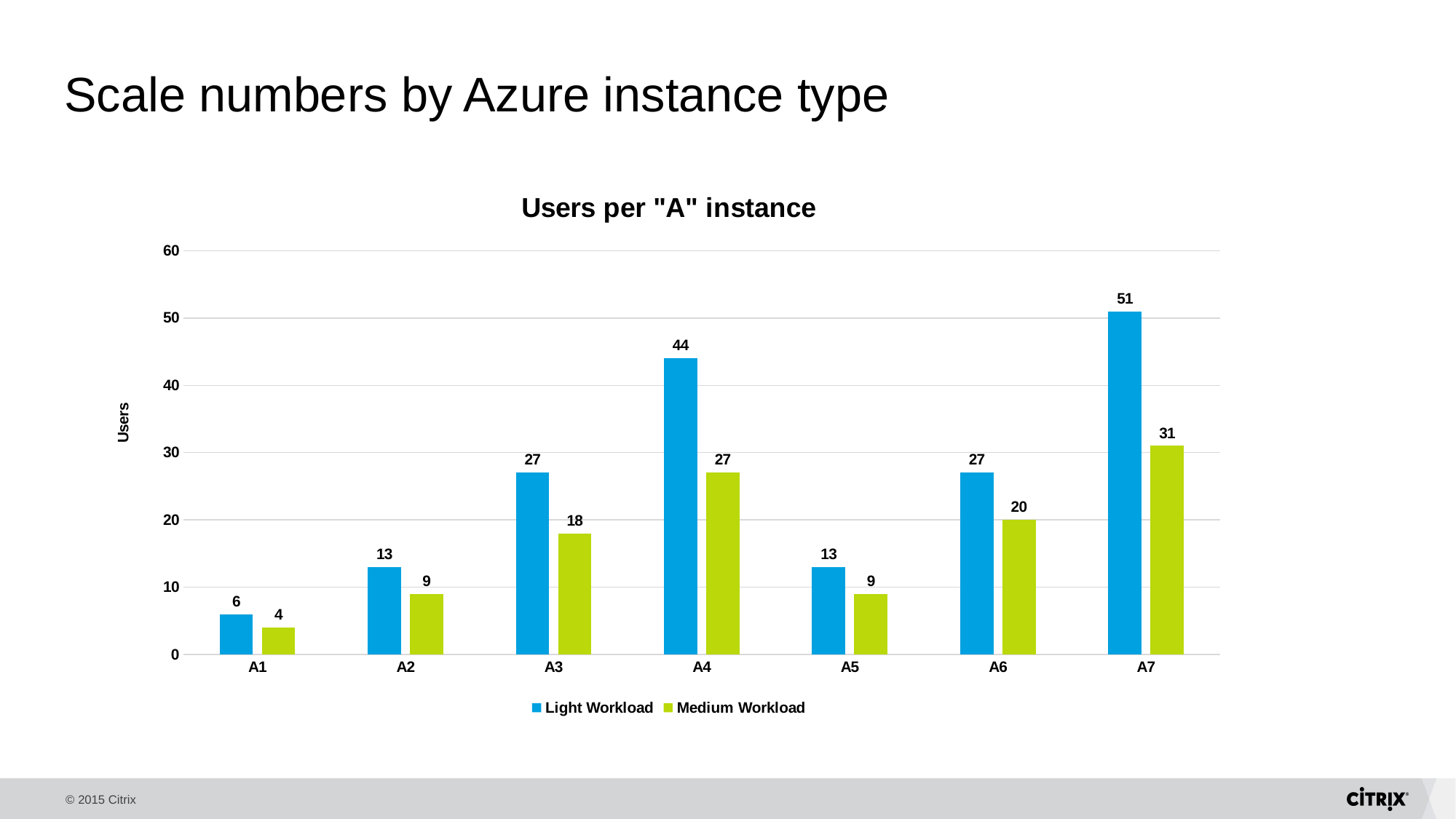
How many instance types are shown on the x axis? 7 What kind of chart is shown on the slide? Bar chart Which instance type has the lowest Medium Workload value? A1 How many series does the legend list? 2 What is the Medium Workload value for A3? 18 What is the Light Workload value for A4? 44 What is the title of the chart? Users per "A" instance Which instance type has the highest Light Workload value? A7 Which is larger: the Light Workload value for A4 or the Light Workload value for A6? A4 What is the label of the y axis? Users What is the Medium Workload value for A1? 4 What is the difference between the Light Workload and Medium Workload values for A7? 20